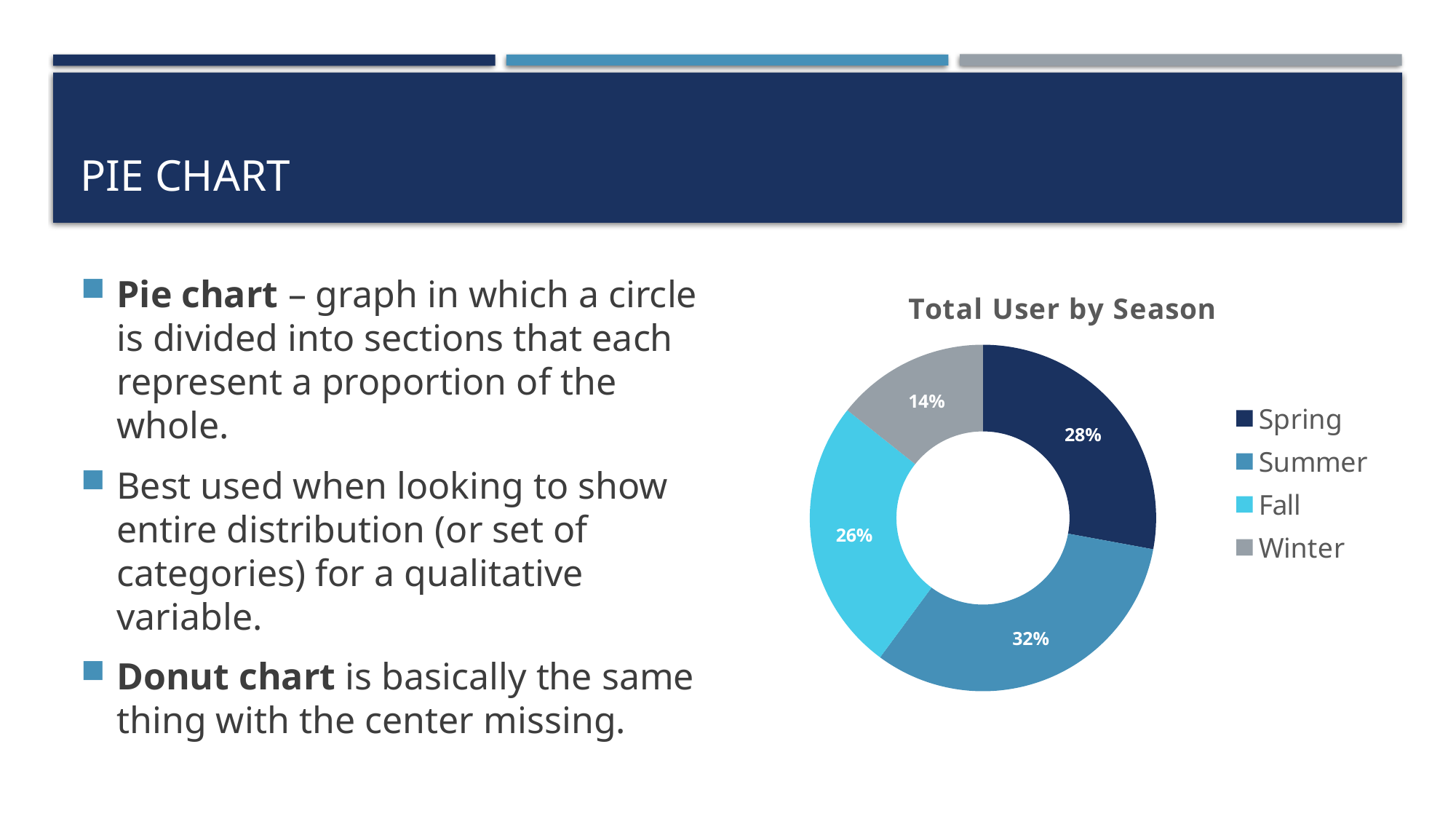
Which season has the smallest share in the Total User by Season chart? Winter What is the title of the chart on the slide? Total User by Season What is the difference between the Summer and Winter shares in the Total User by Season chart? 18% How many seasons are shown in the Total User by Season chart? 4 What is the value for Winter in the Total User by Season chart? 14% What is the value for Spring in the Total User by Season chart? 28% Which is larger in the Total User by Season chart, Spring or Fall? Spring Which legend entry is shown in grey in the Total User by Season chart? Winter What is the value for Fall in the Total User by Season chart? 26% What is the value for Summer in the Total User by Season chart? 32% Which season has the largest share in the Total User by Season chart? Summer What kind of chart is Total User by Season? Donut chart